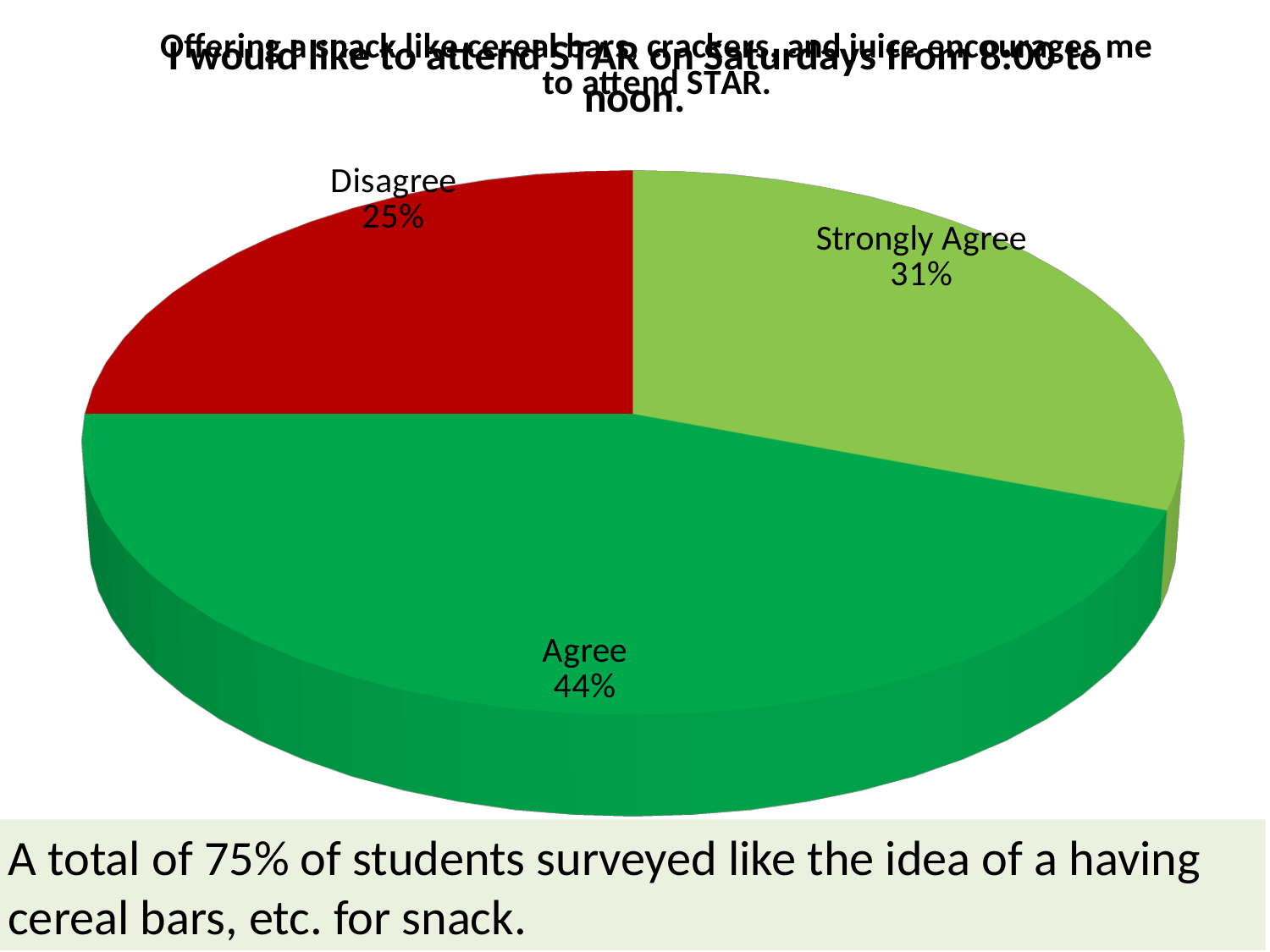
What kind of chart is shown on the slide? pie chart How many slices does the pie chart have? 3 Which slice of the pie chart is the largest? Agree Which slice of the pie chart is the smallest? Disagree What percentage of the pie is labelled Disagree? 25% What is the difference in percentage points between the Agree slice and the Strongly Agree slice? 13 What is the combined share of the Strongly Agree and Agree slices? 75% Which is larger, the Strongly Agree slice or the Disagree slice? Strongly Agree What percentage of the pie is labelled Agree? 44% What is the difference in percentage points between the Agree slice and the Disagree slice? 19 What colour is the Disagree slice of the pie chart? red What percentage of the pie is labelled Strongly Agree? 31%